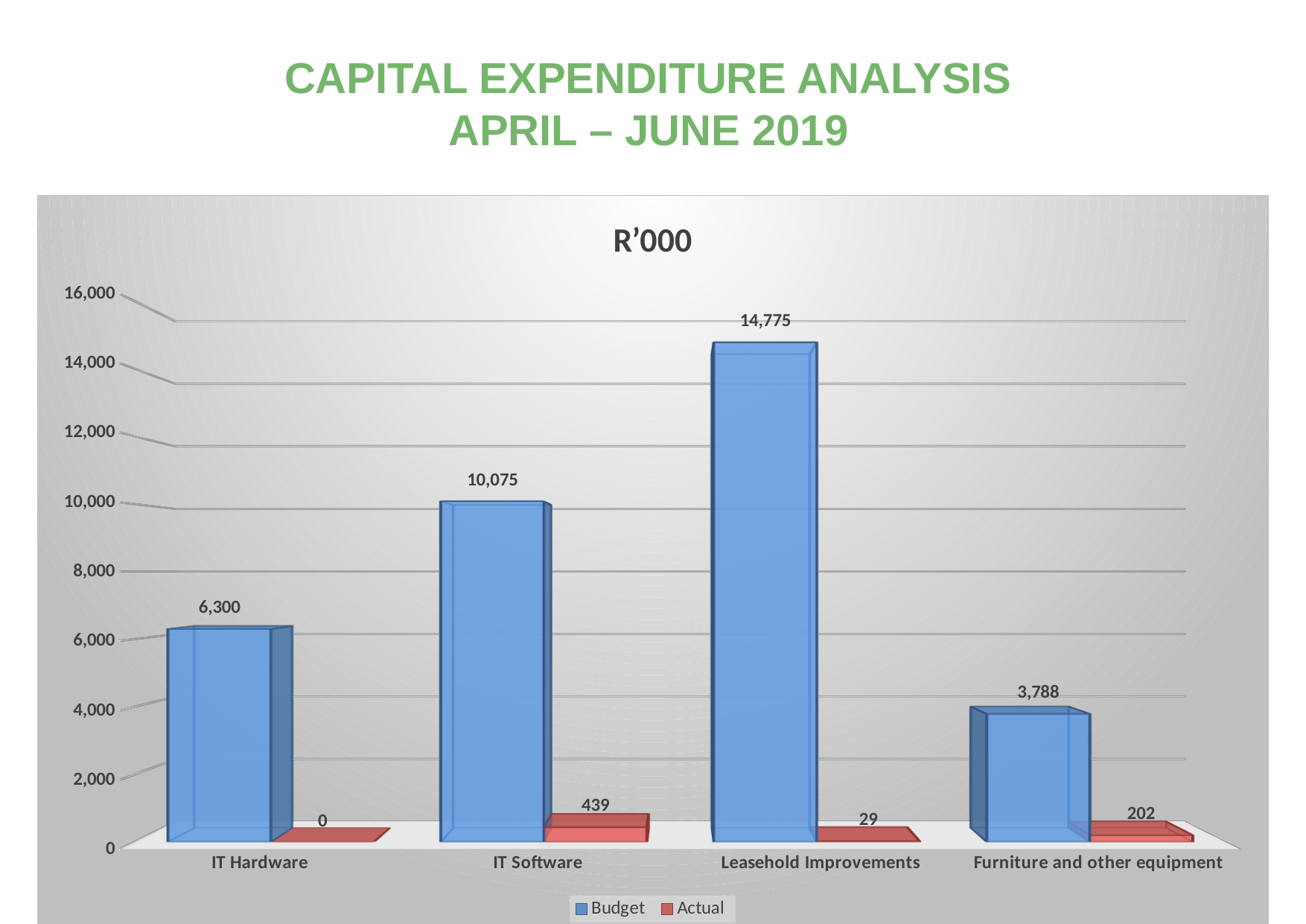
What kind of chart is shown on the slide? bar chart What is the title shown above the chart's plot area? R'000 Which category has the lowest Actual value? IT Hardware Which is larger, the Actual value for IT Software or the Actual value for Furniture and other equipment? IT Software What is the Budget value for IT Software? 10,075 How many categories are shown on the x axis? 4 Which category has the highest Budget value? Leasehold Improvements What is the Actual value for Furniture and other equipment? 202 Is the Budget value for IT Hardware greater or less than 8,000? less What is the difference between the Budget and Actual values for Leasehold Improvements? 14,746 How many series does the legend list? 2 What is the Actual value for IT Hardware? 0